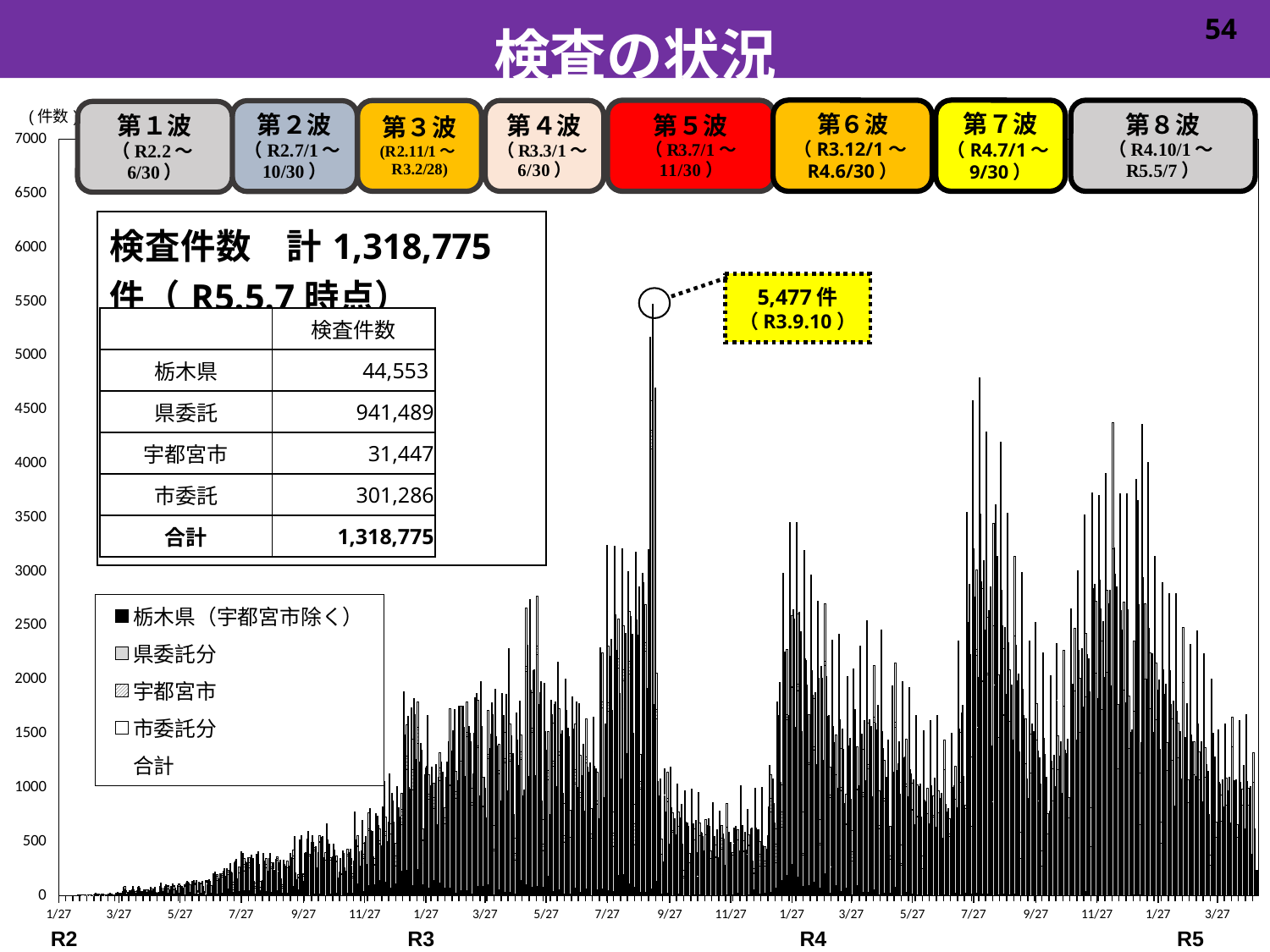
How many waves (波) are labelled across the top of the chart? 8 According to the table on the slide, what is the total number of tests (合計)? 1,318,775 Is the annotated peak value on R3.9.10 greater or less than 5000? greater According to the table on the slide, what is the difference between 県委託 and 栃木県 test counts? 896,936 Which wave contains the highest daily bar on the chart? 第５波 Is the peak bar in 第５波 larger or smaller than the peak bar in 第６波? larger What kind of chart is shown on the slide? bar chart Is the value at 1/27 R2 greater or less than 500? less What is the annotated peak daily value on the chart, and on what date did it occur? 5,477 件 (R3.9.10) Do the daily values rise or fall from 1/27 R2 to 9/27 R2? rise What is the title of the slide chart? 検査の状況 How many series does the chart legend list? 5